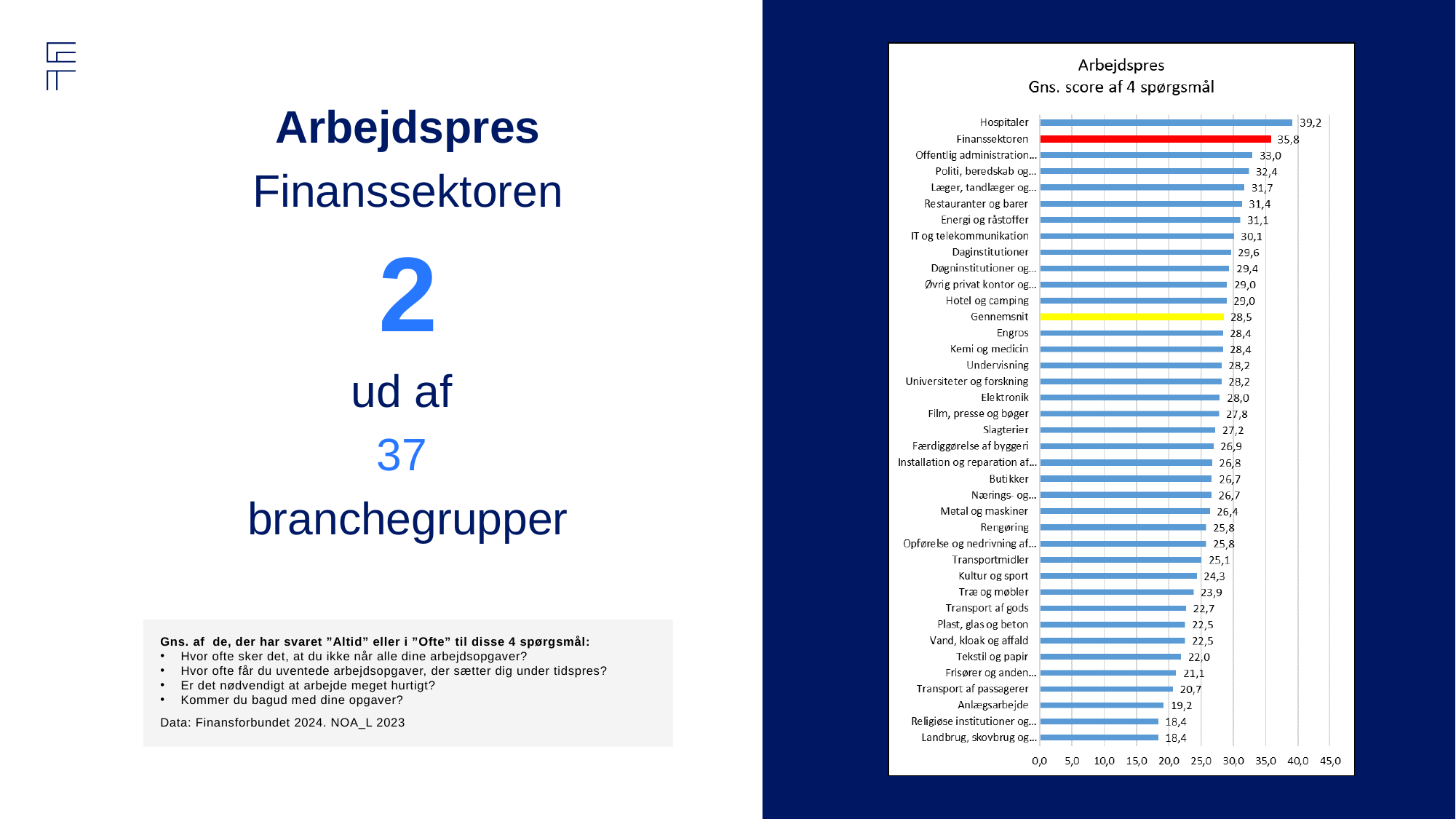
What is the difference between the values for Finanssektoren and Gennemsnit? 7,3 Is the value for Kultur og sport greater or less than 25,0? less What is the title of the chart? Arbejdspres Gns. score af 4 spørgsmål Which has a larger value, Hotel og camping or Transport af gods? Hotel og camping What is the value for Hospitaler? 39,2 Which category has the highest value? Hospitaler What is the value for Gennemsnit? 28,5 What type of chart is shown on the slide? bar chart What is the value for Anlægsarbejde? 19,2 What colour is the bar for Gennemsnit? yellow What is the value for Finanssektoren? 35,8 What is the difference between the values for Hospitaler and Finanssektoren? 3,4